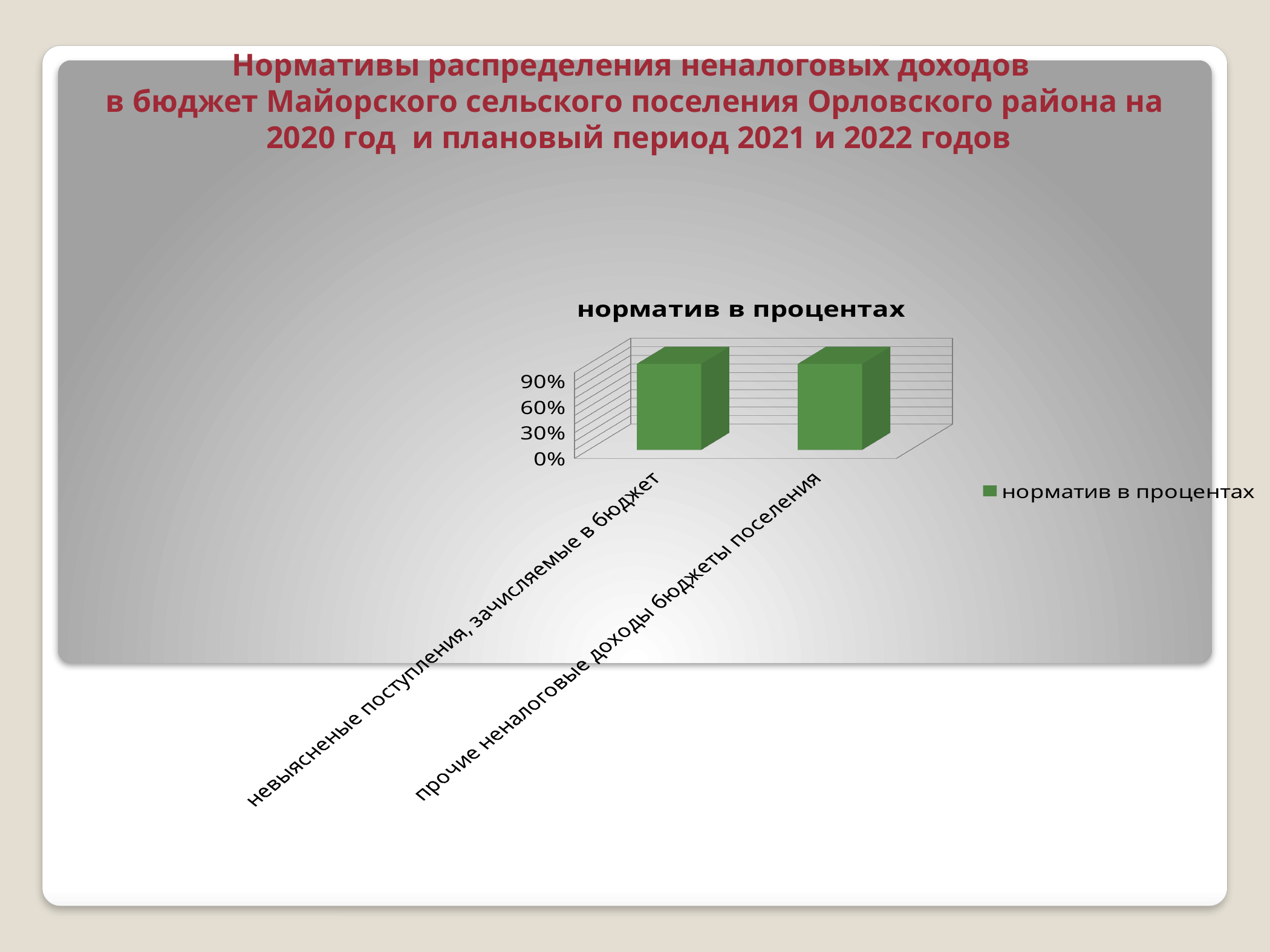
Is the value for "невыясненые поступления, зачисляемые в бюджет" greater or less than 30%? greater How many series does the chart legend list? 1 Is the value for "невыясненые поступления, зачисляемые в бюджет" greater or less than 60%? greater Is the value for "прочие неналоговые доходы бюджеты поселения" greater or less than 60%? greater What kind of chart is shown on the slide? bar chart How many categories are shown on the x axis of the chart? 2 What series name is shown in the chart legend? норматив в процентах What is the title of the chart? норматив в процентах